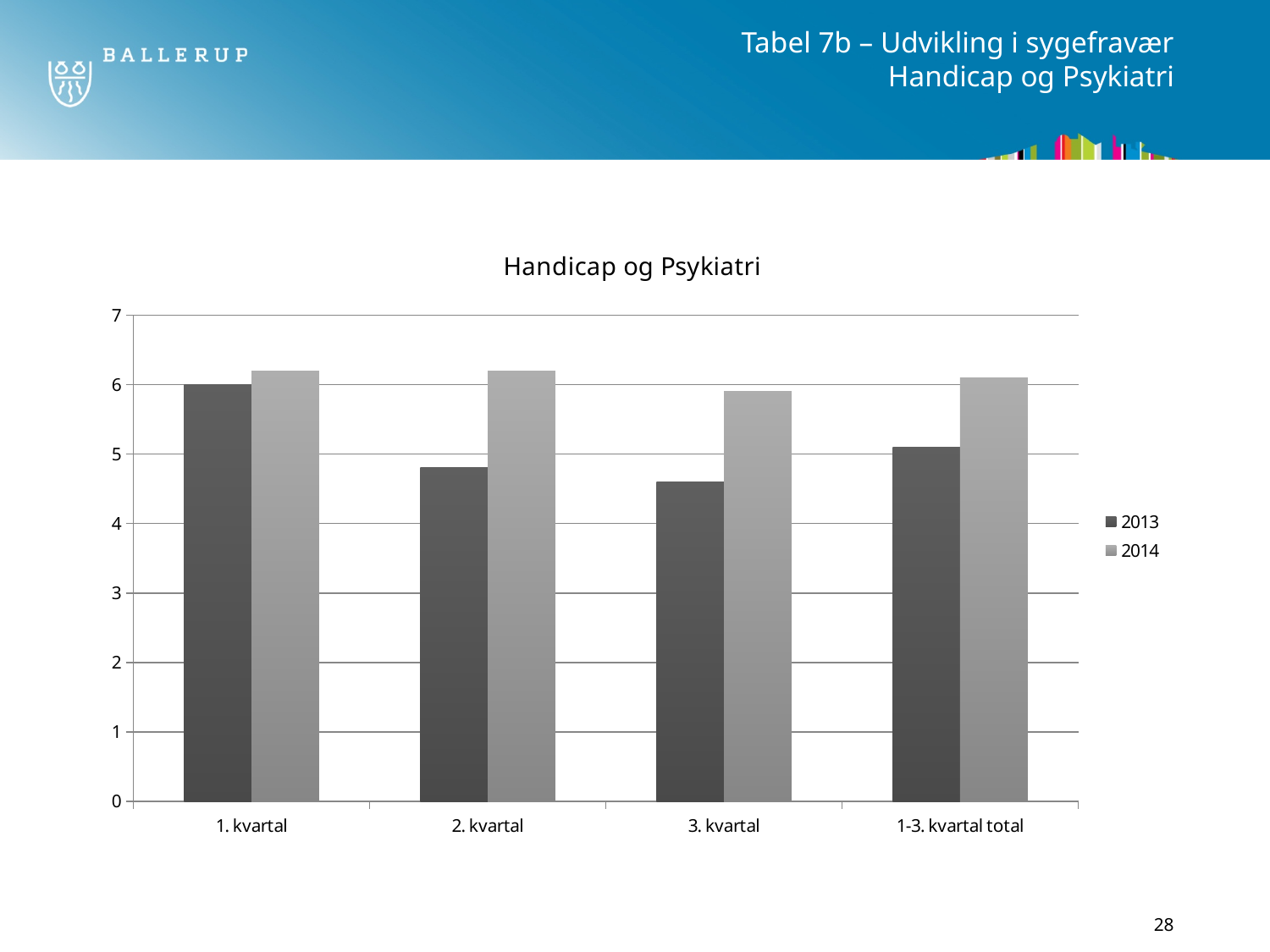
Which category has the highest value for the 2013 series? 1. kvartal What is the title of the chart? Handicap og Psykiatri In 2. kvartal, which series has the larger value, 2013 or 2014? 2014 Is the value for 2014 in 1. kvartal greater or less than 6? greater Is the value for 2013 in 3. kvartal greater or less than 4? greater Which series does the legend list first? 2013 How many series does the legend list? 2 What kind of chart is shown on the slide? bar chart How many categories are shown on the x axis? 4 Which category has the lowest value for the 2013 series? 3. kvartal Is the value for 2013 in 2. kvartal greater or less than 5? less